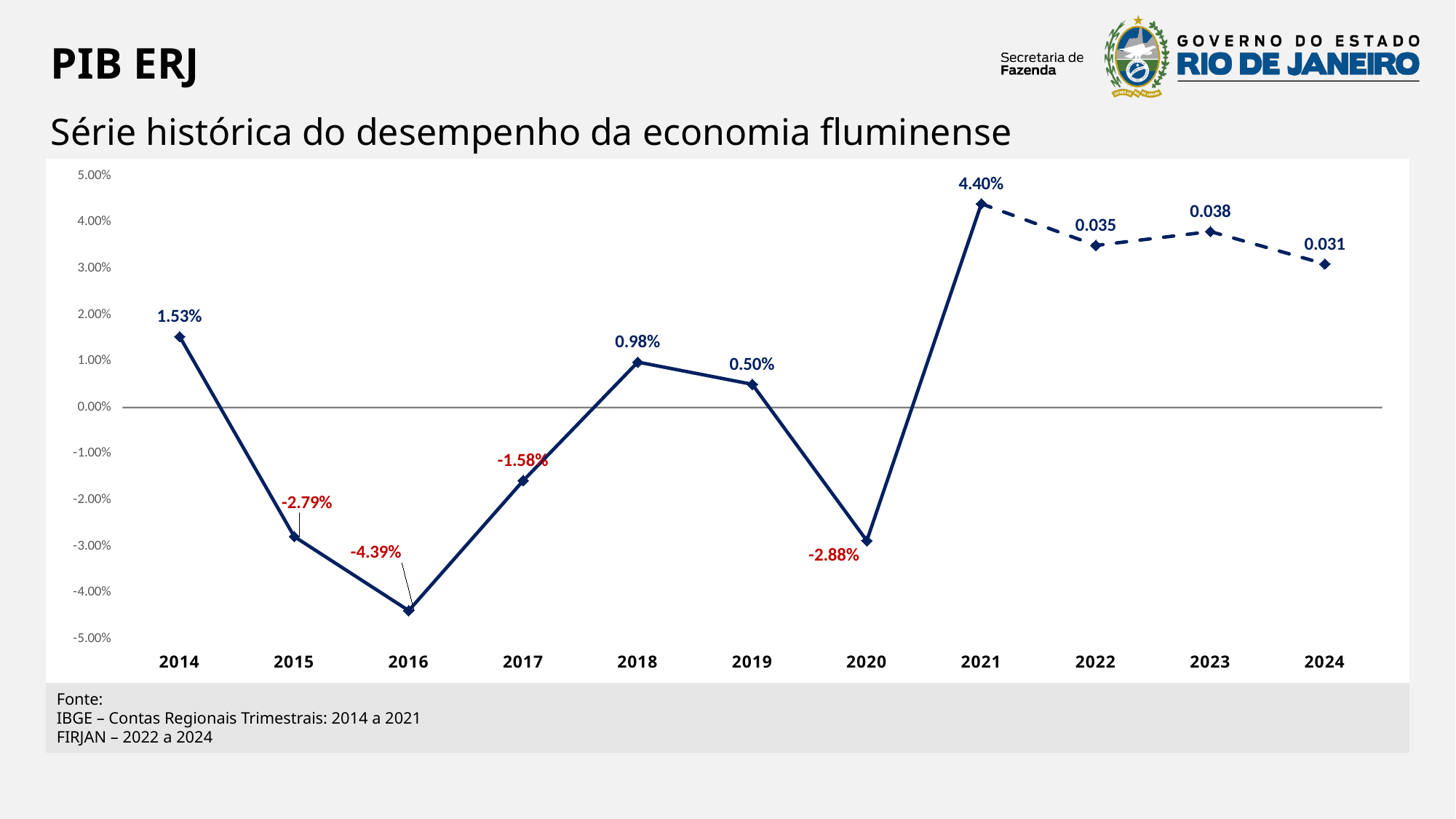
Do the values rise or fall from 2014 to 2016? Fall What is the difference between the values for 2018 and 2019? 0.48 percentage points What is the value plotted for 2016? -4.39% What is the value plotted for 2014? 1.53% Is the value for 2022 greater or less than 3.00%? greater What data label is shown for 2023? 0.038 What is the value plotted for 2021? 4.40% How many years are plotted on the x axis? 11 What type of chart is shown on the slide? Line chart Which year has the lowest value on the chart? 2016 Which year has the highest value on the chart? 2021 Which year has the larger value, 2015 or 2020? 2015